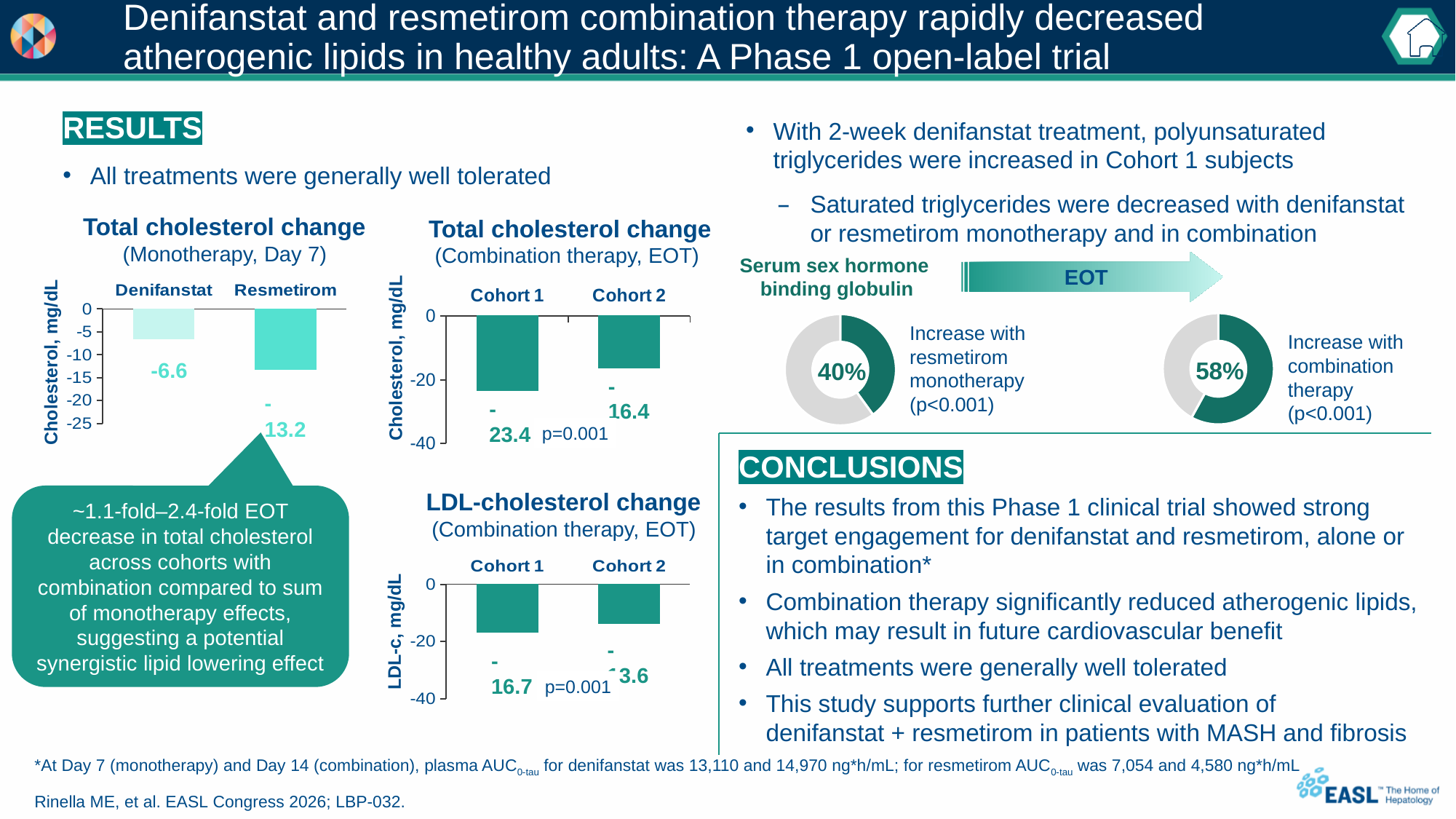
In the 'Total cholesterol change (Monotherapy, Day 7)' chart, what is the value for Denifanstat? -6.6 In the 'Serum sex hormone binding globulin' donut charts, what percentage increase is shown with combination therapy? 58% In the 'Total cholesterol change (Monotherapy, Day 7)' chart, which treatment shows the larger decrease in cholesterol? Resmetirom What kind of chart is the 'Total cholesterol change (Monotherapy, Day 7)' chart? Bar chart In the 'Total cholesterol change (Monotherapy, Day 7)' chart, what is the value for Resmetirom? -13.2 In the 'Total cholesterol change (Combination therapy, EOT)' chart, what is the value for Cohort 2? -16.4 In the 'LDL-cholesterol change (Combination therapy, EOT)' chart, is the value for Cohort 2 greater or less than -20? greater In the 'LDL-cholesterol change (Combination therapy, EOT)' chart, what is the value for Cohort 1? -16.7 In the 'Total cholesterol change (Monotherapy, Day 7)' chart, what is the difference between the Resmetirom and Denifanstat values? 6.6 In the 'Total cholesterol change (Combination therapy, EOT)' chart, what is the value for Cohort 1? -23.4 In the 'Total cholesterol change (Combination therapy, EOT)' chart, what is the difference between the Cohort 1 and Cohort 2 values? 7.0 In the 'Serum sex hormone binding globulin' donut charts, what percentage increase is shown with resmetirom monotherapy? 40%